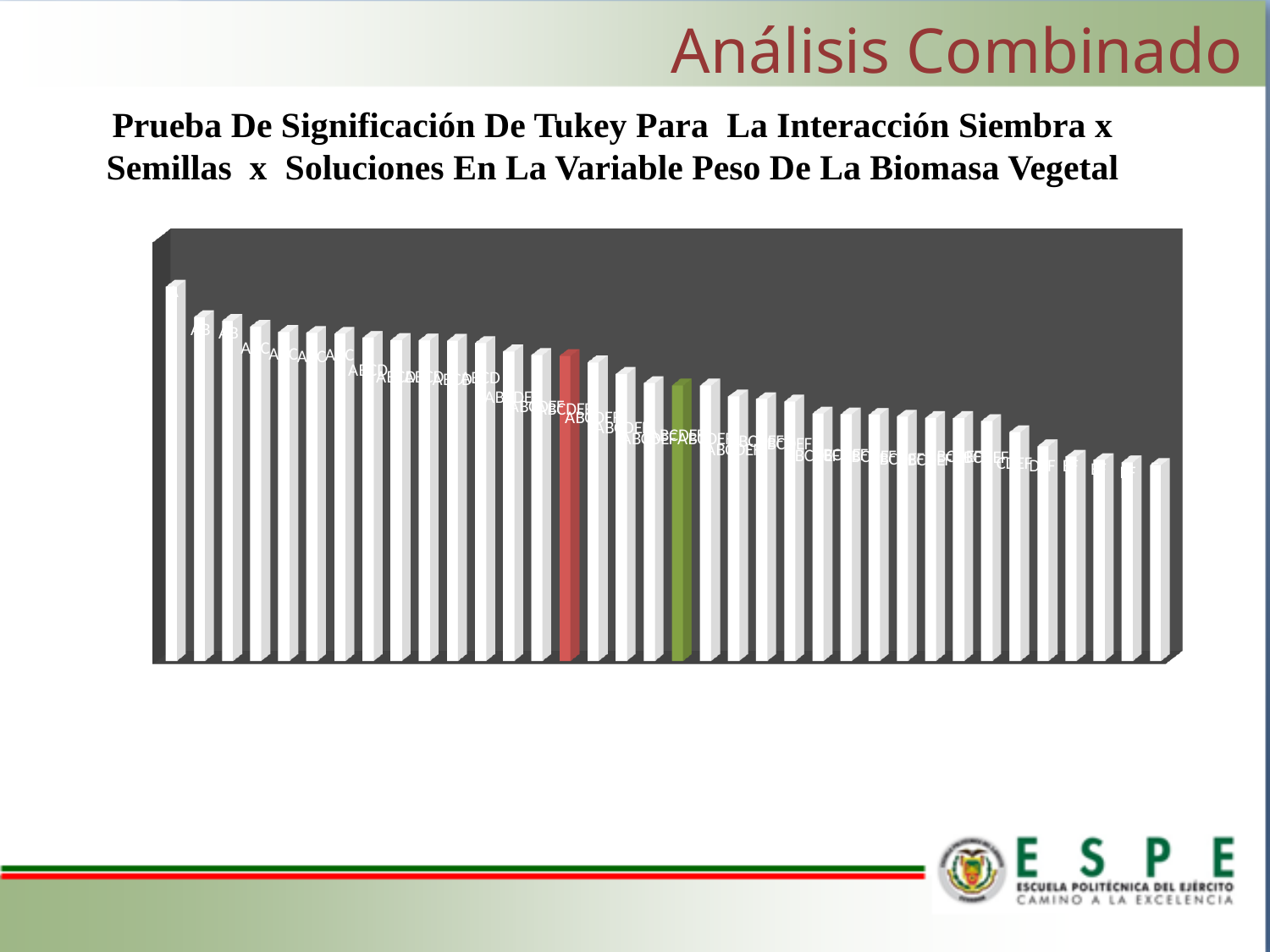
Which statistical test does the chart's title say the results come from? Tukey Where is the tallest bar located in the chart? at the far left Where is the shortest bar located in the chart? at the far right Do the bar heights rise or fall from left to right across the chart? fall Which bar is taller, the red bar or the green bar? the red bar What kind of chart is shown on the slide? bar chart Which of the two coloured bars, red or green, is positioned further to the left? the red bar Which bar is taller, the leftmost bar or the rightmost bar? the leftmost bar How many bars are coloured differently from the white bars, and what colours are they? two: one red and one green